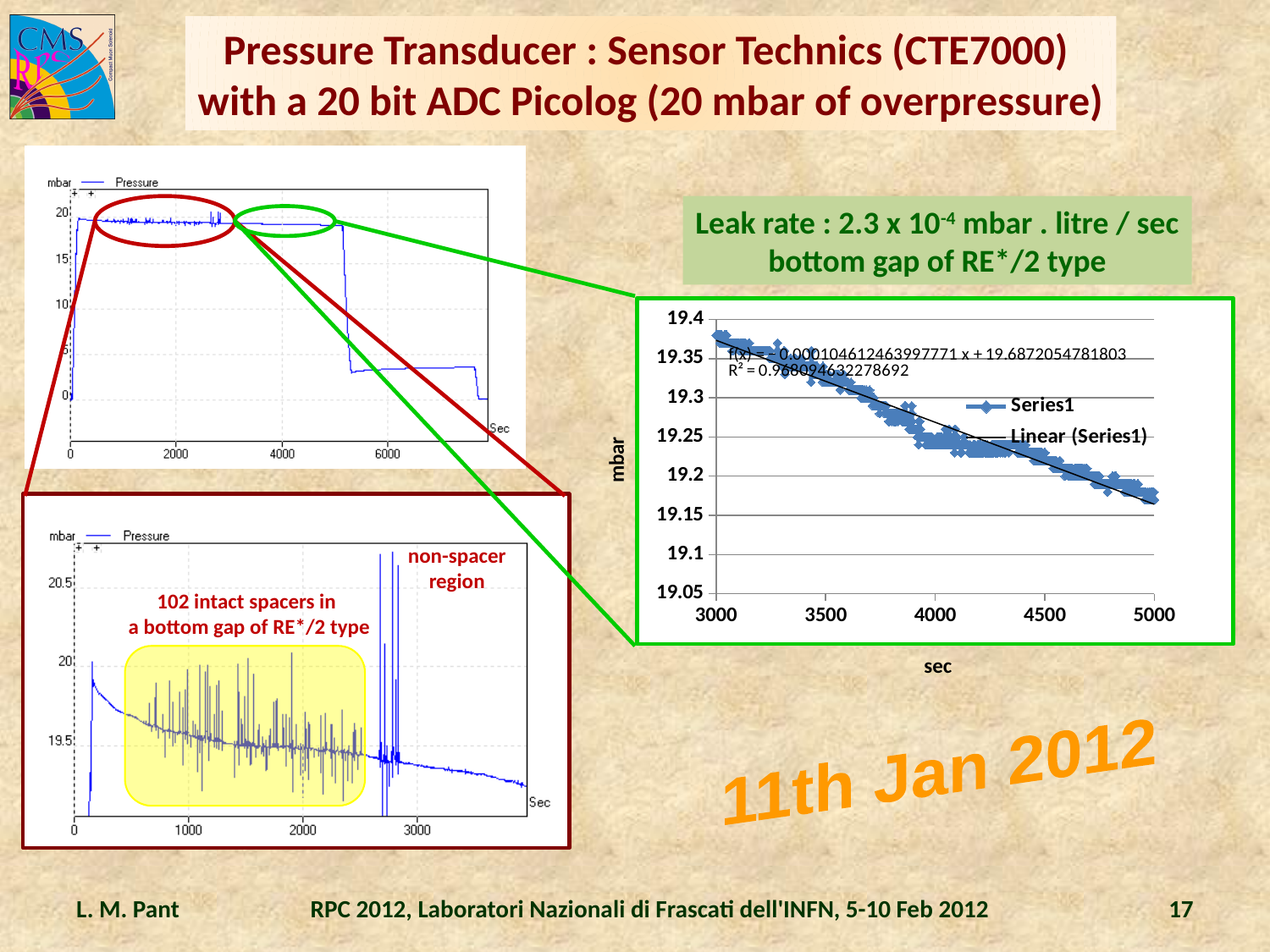
On the right-hand chart (mbar vs sec), how many entries does the legend list? 2 On the right-hand chart (mbar vs sec), do the plotted values rise or fall as sec increases from 3000 to 5000? fall On the right-hand chart (mbar vs sec), is the value at 3000 sec greater or less than 19.35? greater On the bottom-left chart (Pressure, 0 to 3000 Sec), is the pressure at 3000 Sec greater or less than 19.5 mbar? less On the right-hand chart (mbar vs sec), what is the intercept of the fitted linear trendline equation shown on the chart? 19.6872054781803 On the top-left chart (Pressure, 0 to 6000 Sec), is the pressure at 6000 Sec greater or less than 5 mbar? less On the right-hand chart (mbar vs sec), what are the two legend entries? Series1 and Linear (Series1) On the right-hand chart (mbar vs sec), what is the lowest tick value shown on the vertical axis? 19.05 How many charts are shown on the slide? 3 On the right-hand chart (mbar vs sec), what is the label of the vertical axis? mbar